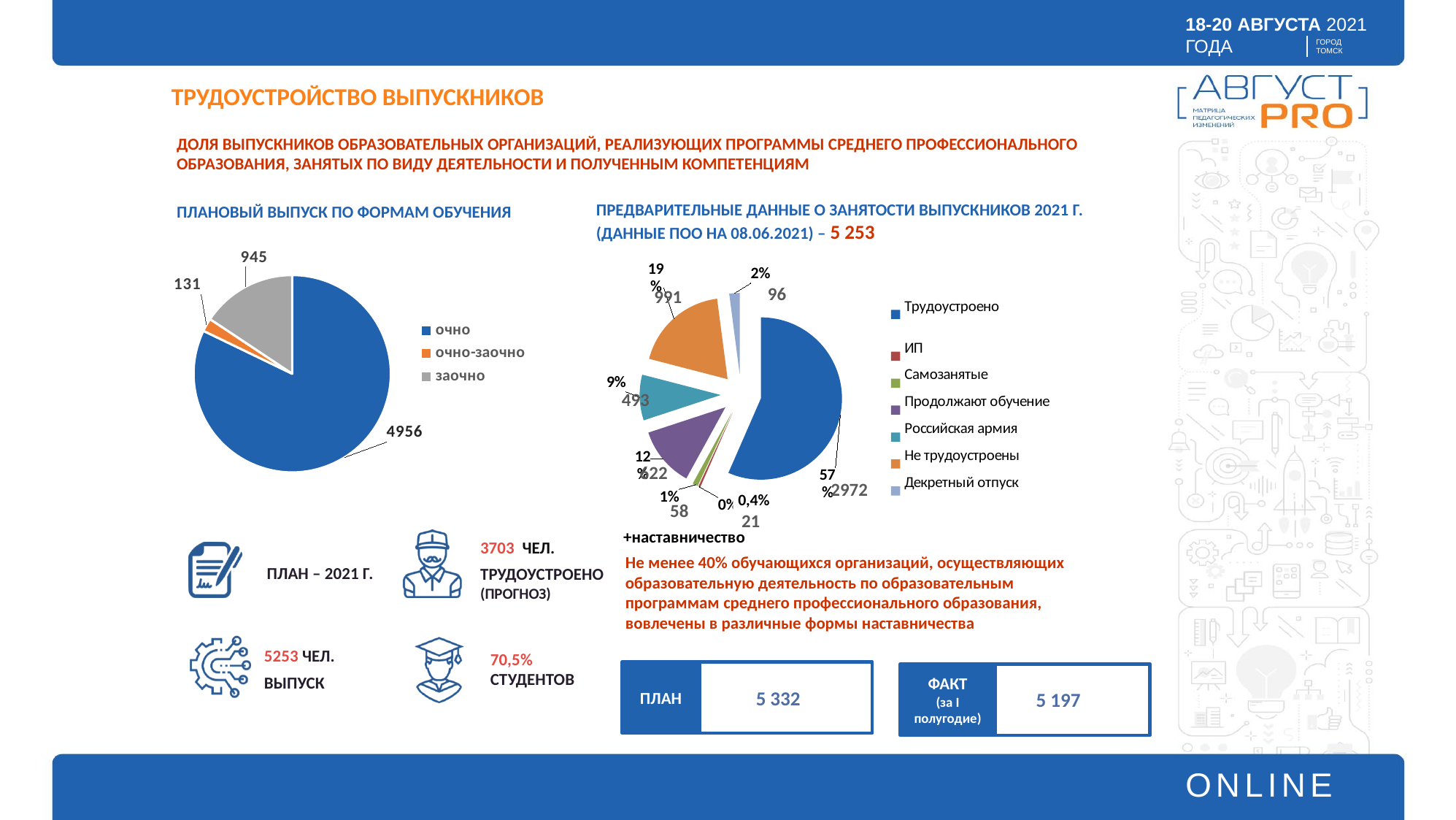
On the chart 'ПРЕДВАРИТЕЛЬНЫЕ ДАННЫЕ О ЗАНЯТОСТИ ВЫПУСКНИКОВ 2021 Г.', how many series does the legend list? 7 On the chart 'ПЛАНОВЫЙ ВЫПУСК ПО ФОРМАМ ОБУЧЕНИЯ', how many categories does the legend list? 3 What type of chart is 'ПЛАНОВЫЙ ВЫПУСК ПО ФОРМАМ ОБУЧЕНИЯ'? Pie chart On the chart 'ПЛАНОВЫЙ ВЫПУСК ПО ФОРМАМ ОБУЧЕНИЯ', what is the value for 'заочно'? 945 On the chart 'ПРЕДВАРИТЕЛЬНЫЕ ДАННЫЕ О ЗАНЯТОСТИ ВЫПУСКНИКОВ 2021 Г.', which is larger: 'Продолжают обучение' or 'Декретный отпуск'? Продолжают обучение On the chart 'ПРЕДВАРИТЕЛЬНЫЕ ДАННЫЕ О ЗАНЯТОСТИ ВЫПУСКНИКОВ 2021 Г.', what is the value for 'Не трудоустроены'? 991 On the chart 'ПЛАНОВЫЙ ВЫПУСК ПО ФОРМАМ ОБУЧЕНИЯ', which form of study has the smallest value? очно-заочно On the chart 'ПРЕДВАРИТЕЛЬНЫЕ ДАННЫЕ О ЗАНЯТОСТИ ВЫПУСКНИКОВ 2021 Г.', what is the value for 'Российская армия'? 493 On the chart 'ПРЕДВАРИТЕЛЬНЫЕ ДАННЫЕ О ЗАНЯТОСТИ ВЫПУСКНИКОВ 2021 Г.', what share of the pie is 'Трудоустроено'? 57% On the chart 'ПРЕДВАРИТЕЛЬНЫЕ ДАННЫЕ О ЗАНЯТОСТИ ВЫПУСКНИКОВ 2021 Г.', what is the value for 'Трудоустроено'? 2972 On the chart 'ПЛАНОВЫЙ ВЫПУСК ПО ФОРМАМ ОБУЧЕНИЯ', what is the value for 'очно'? 4956 On the chart 'ПЛАНОВЫЙ ВЫПУСК ПО ФОРМАМ ОБУЧЕНИЯ', what is the difference between the values for 'заочно' and 'очно-заочно'? 814